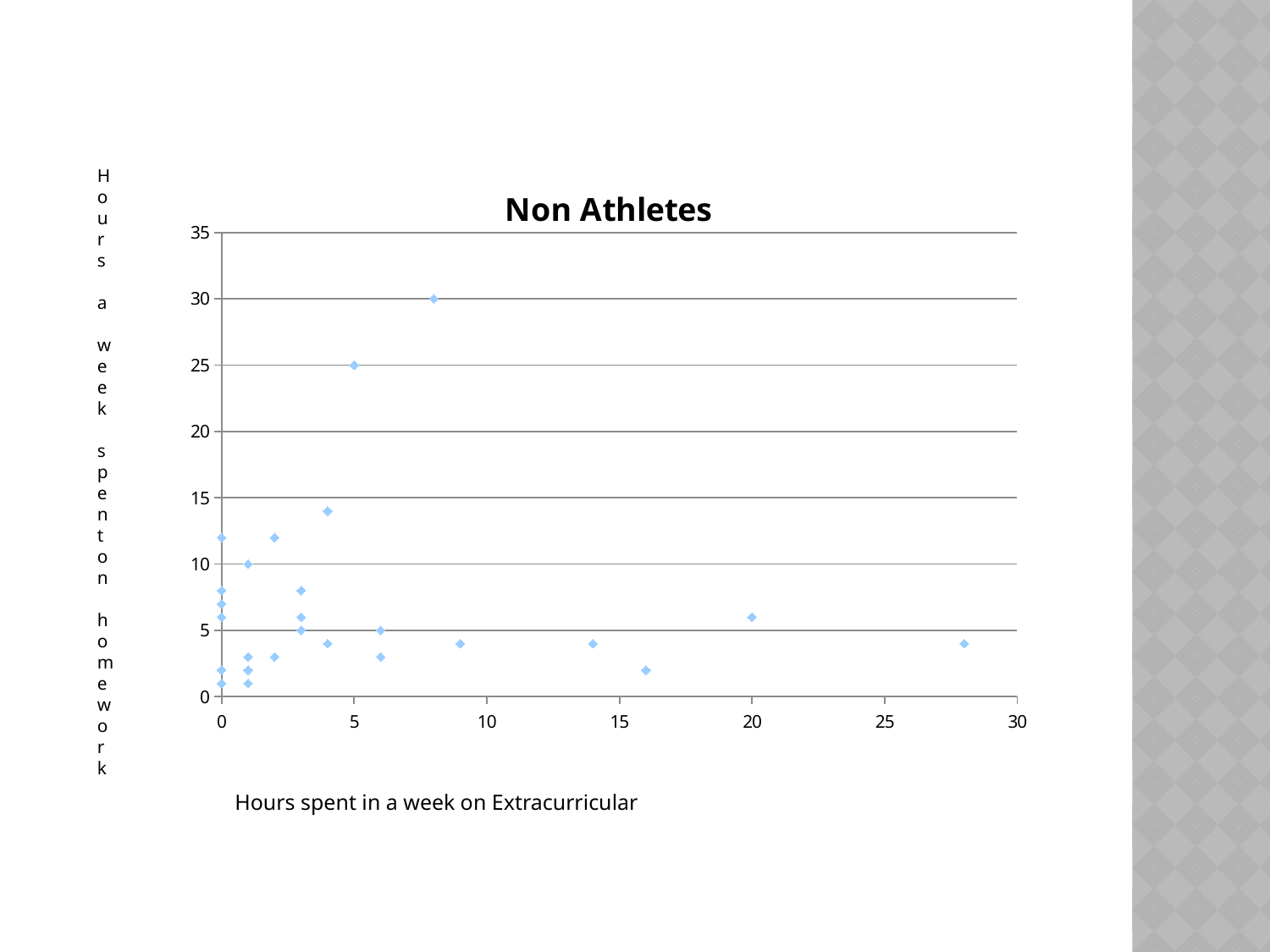
Is the homework value for the point at 20 hours of extracurricular greater or less than 5? greater Is the homework value for the point at 28 hours of extracurricular greater or less than 5? less Is the extracurricular value of the rightmost point greater or less than 25? greater Which point has a higher homework value: the one at 8 hours of extracurricular or the one at 5 hours of extracurricular? the one at 8 hours What is the title of the chart? Non Athletes What is the highest homework value plotted on the chart? 30 What is the maximum value shown on the vertical axis? 35 What is the label of the horizontal axis? Hours spent in a week on Extracurricular What is the homework value for the point at 5 hours of extracurricular? 25 What kind of chart is shown on the slide? scatter chart